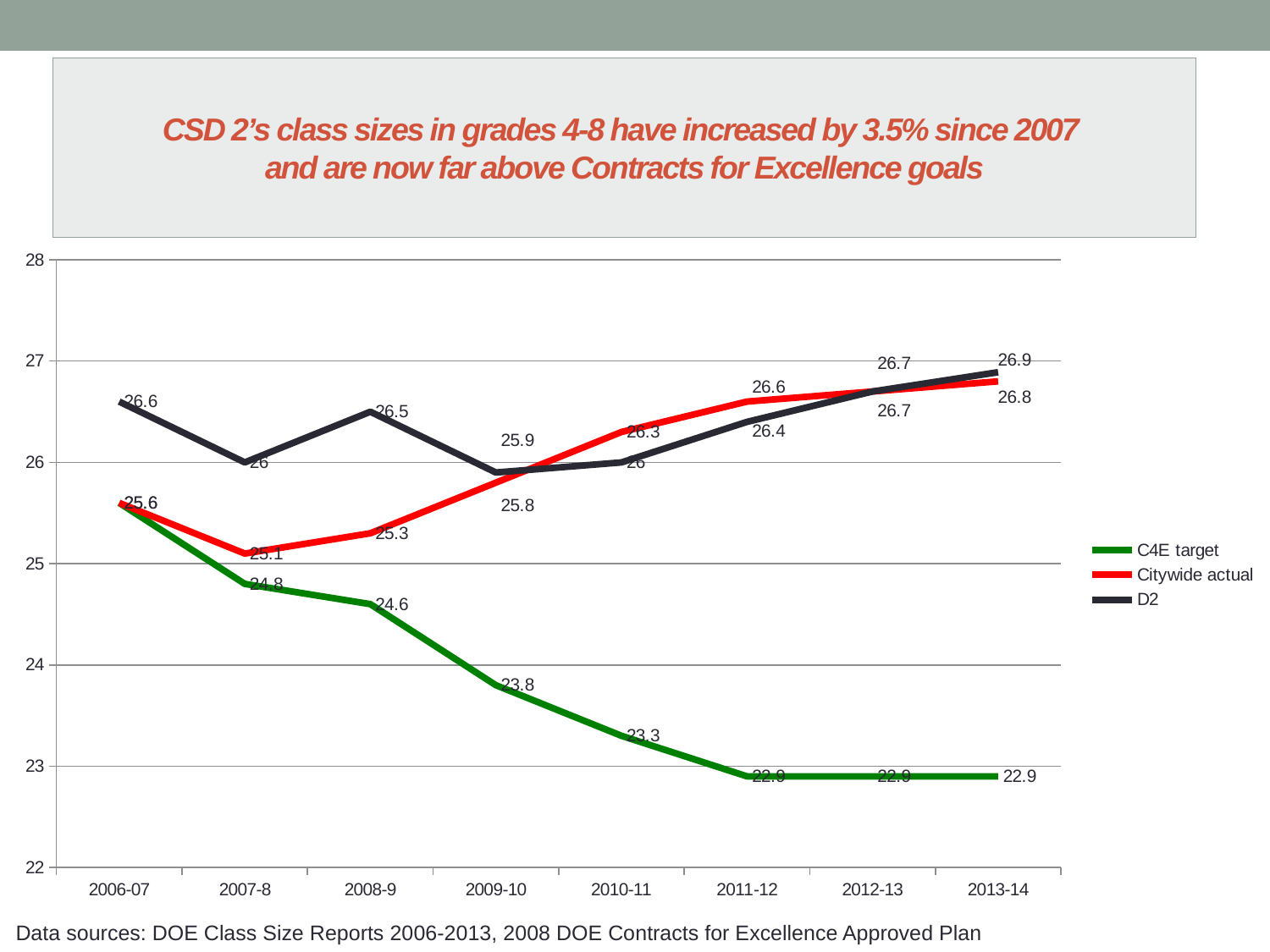
In 2011-12, which is larger: the Citywide actual value or the D2 value? Citywide actual What colour is the Citywide actual line in the legend? red What is the D2 value for 2013-14? 26.9 What is the difference between the D2 value and the C4E target value in 2013-14? 4 What is the highest D2 value shown? 26.9 What is the C4E target value for 2009-10? 23.8 How many series does the legend list? 3 Does the C4E target line rise or fall from 2006-07 to 2013-14? fall How many school years are plotted along the x axis? 8 What kind of chart is shown on the slide? line chart In which year is the D2 value lowest? 2009-10 What is the Citywide actual value for 2011-12? 26.6